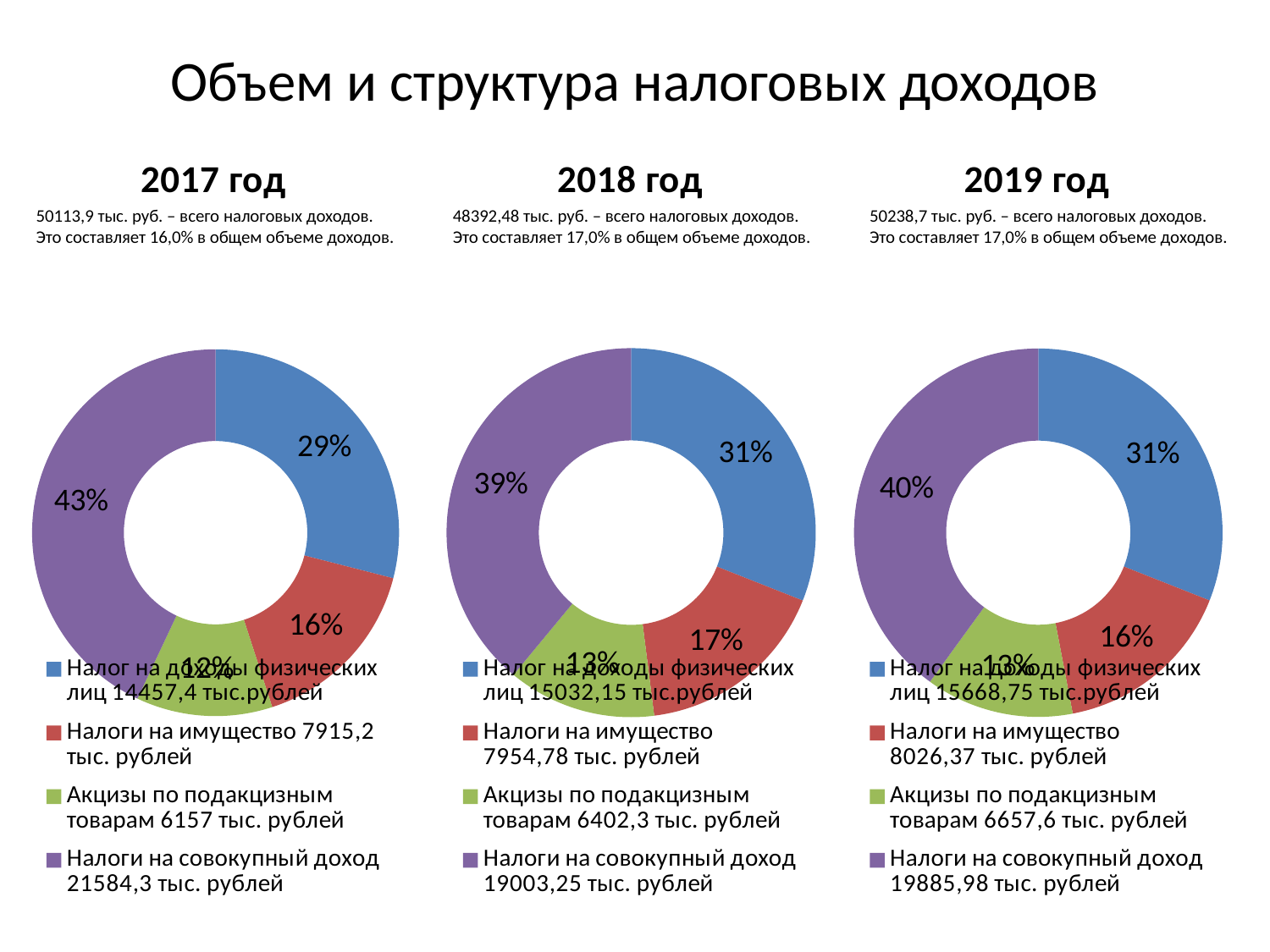
In the 2019 год chart legend, what amount is given for Налоги на совокупный доход? 19885,98 тыс. рублей In the 2019 год chart, which category has the smallest share? Акцизы по подакцизным товарам In the 2019 год chart, what share does Налоги на имущество have? 16% What colour represents Налоги на имущество in the 2017 год chart? Red In the 2017 год chart, what share does Налоги на совокупный доход have? 43% In the 2017 год chart, which category has the largest share? Налоги на совокупный доход In the 2018 год chart, what is the difference in percentage points between Налоги на совокупный доход and Налог на доходы физических лиц? 8 In the 2018 год chart, what share does Акцизы по подакцизным товарам have? 13% What type of chart is used for 2018 год? Doughnut chart In the 2017 год chart, which is larger: the share of Налог на доходы физических лиц or the share of Налоги на имущество? Налог на доходы физических лиц How many slices does the 2019 год chart have? 4